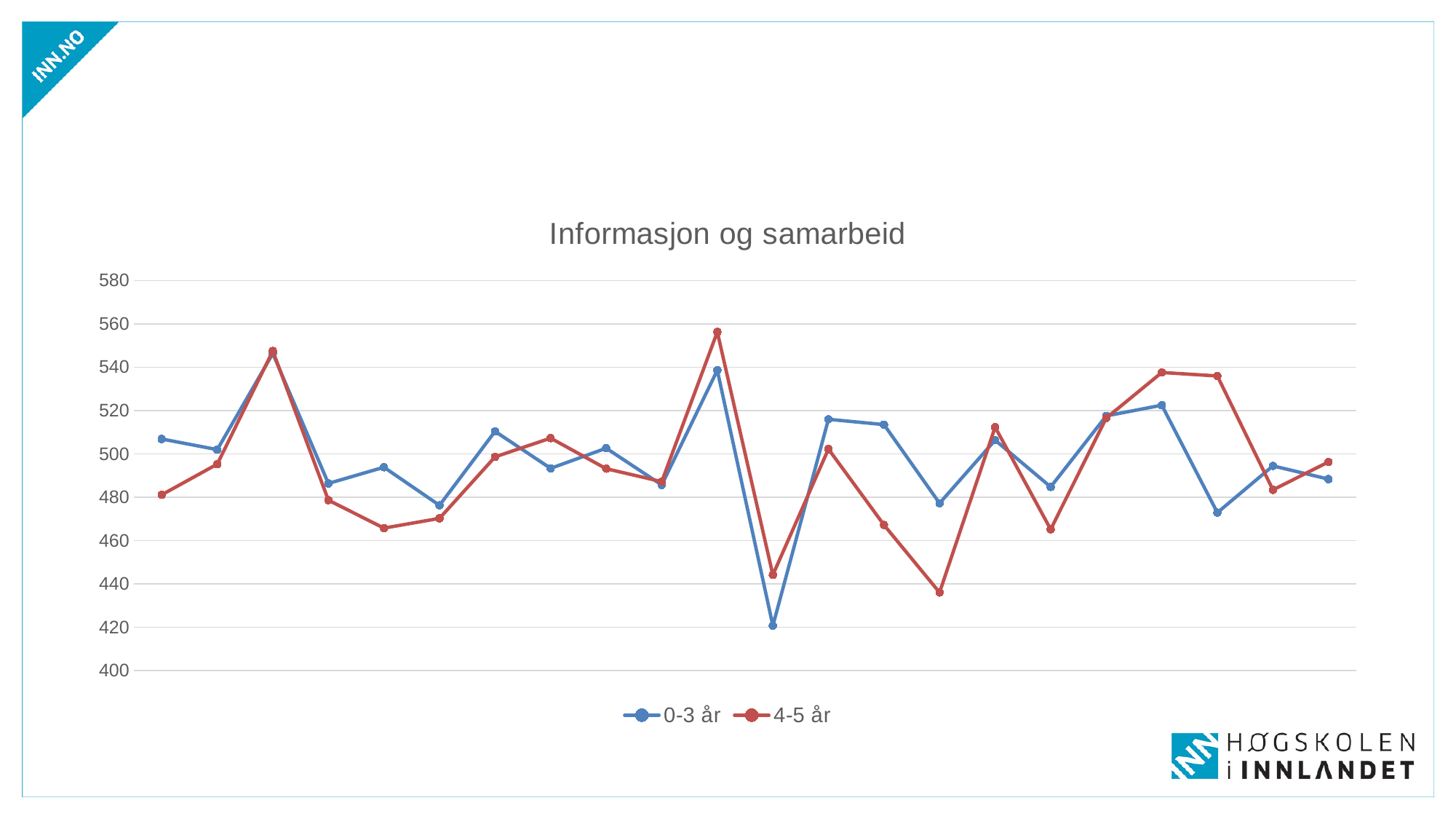
Is the first point of the 4-5 år series greater or less than 500? less Is the highest value of the 4-5 år series greater or less than 540? greater What kind of chart is shown on the slide? line chart What is the title of the chart? Informasjon og samarbeid Is the lowest value of the 0-3 år series greater or less than 440? less Which series contains the lowest value on the chart? 0-3 år How many series does the legend list? 2 At the first data point, which series has the higher value, 0-3 år or 4-5 år? 0-3 år How many data points does each series have? 22 Which series reaches the highest value on the chart? 4-5 år Which series is drawn in red? 4-5 år At the lowest dip in the middle of the chart, which series has the lower value, 0-3 år or 4-5 år? 0-3 år